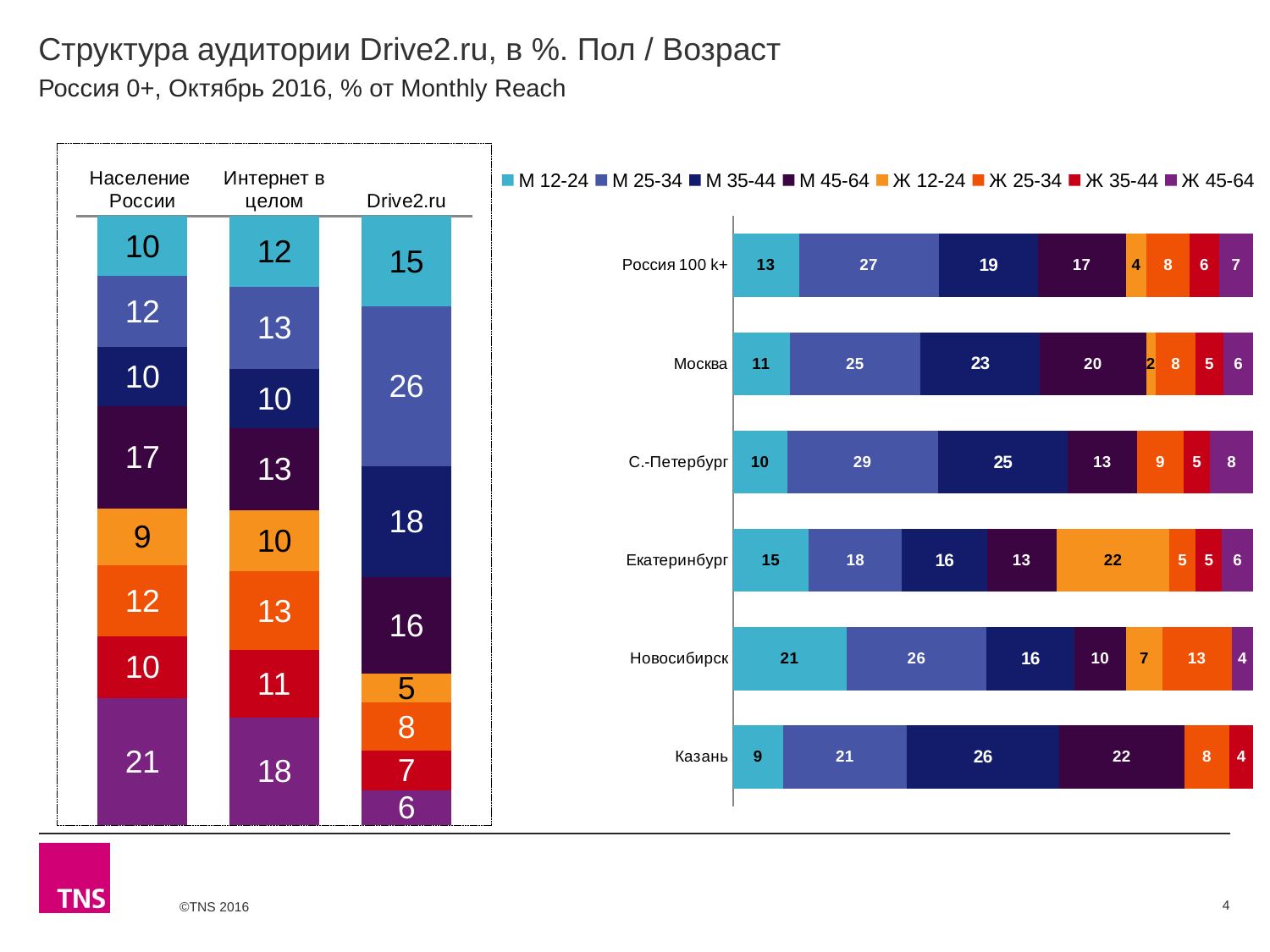
In the right chart, what is the M 12-24 value for Новосибирск? 21 In the right chart, what is the M 35-44 value for Казань? 26 In the right chart, which city has the lowest M 12-24 value? Казань In the right chart, which city has the highest M 25-34 value? С.-Петербург In the left chart, what is the difference between the M 25-34 value for Drive2.ru and the M 25-34 value for Население России? 14 In the left chart, what is the value of the M 25-34 segment for Drive2.ru? 26 In the right chart, which is larger: the M 35-44 value for Москва or for С.-Петербург? С.-Петербург In the left chart, what is the value of the Ж 45-64 segment for Население России? 21 In the left chart, which segment of the Drive2.ru bar is the largest? M 25-34 How many categories (rows) are shown in the right chart? 6 How many series does the legend of the right chart list? 8 In the right chart, what is the Ж 12-24 value for Екатеринбург? 22